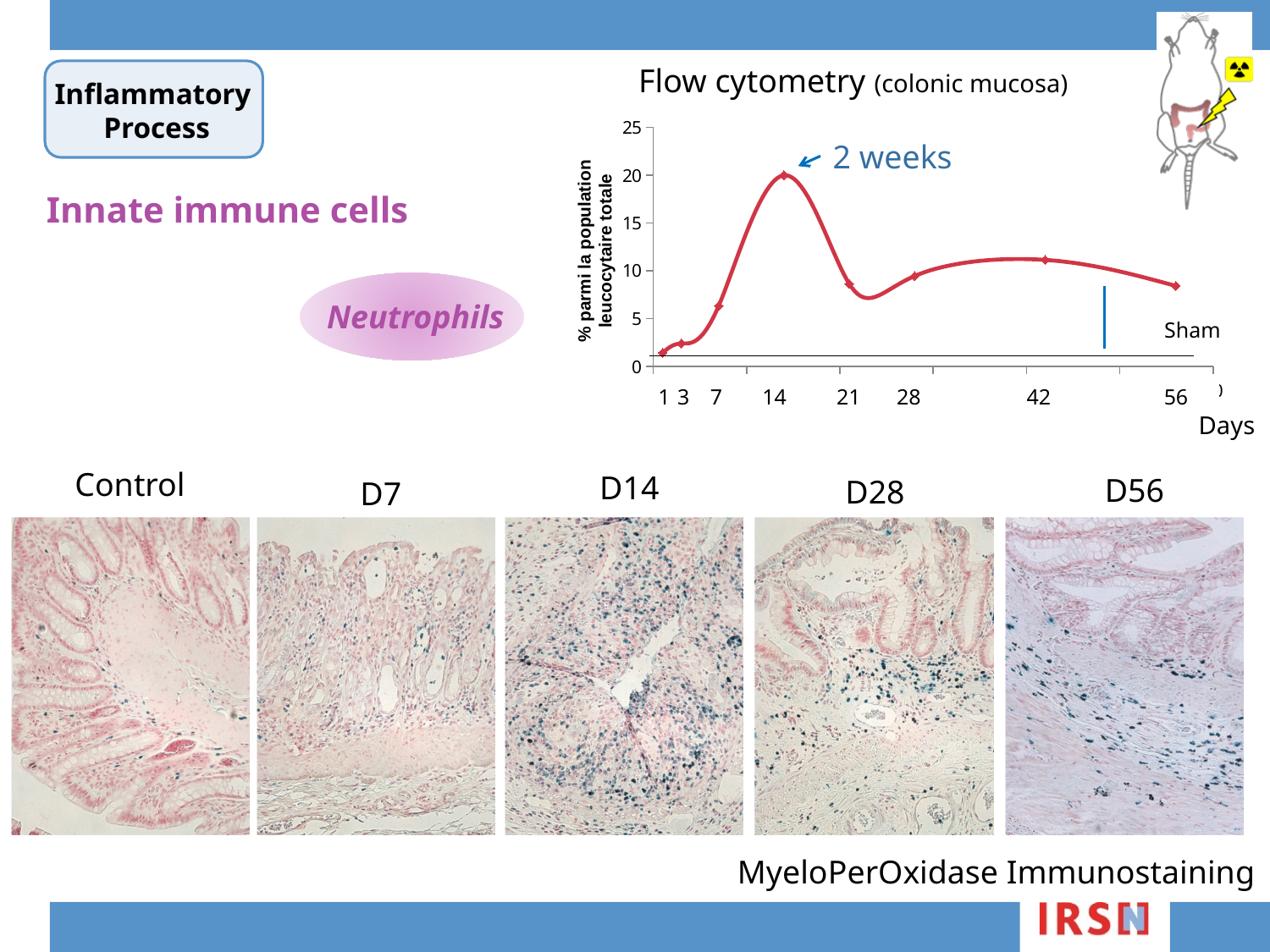
On the flow cytometry chart, is the value at day 1 greater or less than 5? less What kind of chart is shown under the title "Flow cytometry (colonic mucosa)"? line chart How many data points are plotted on the flow cytometry chart? 8 On the flow cytometry chart, at which day does the curve reach its highest value? 14 On the flow cytometry chart, is the value at day 56 greater or less than 10? less What is the label on the y axis of the flow cytometry chart? % parmi la population leucocytaire totale On the flow cytometry chart, is the value at day 42 greater or less than 10? greater On the flow cytometry chart, which has the larger value: day 14 or day 28? day 14 On the flow cytometry chart, at which day is the plotted value lowest? 1 On the flow cytometry chart, does the curve rise or fall between day 14 and day 21? fall On the flow cytometry chart, which has the larger value: day 7 or day 42? day 42